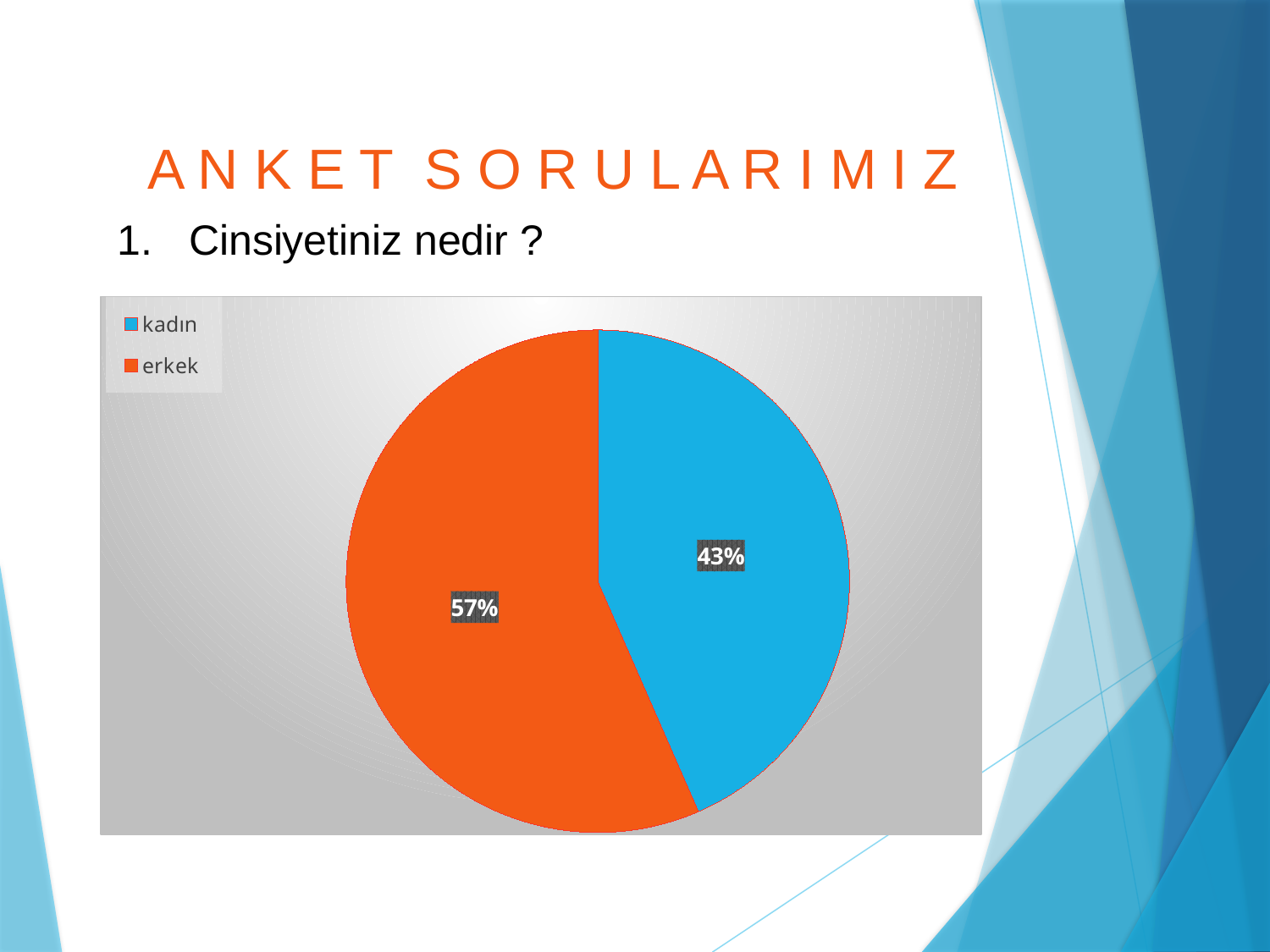
Which category has the largest share of the pie? erkek What colour is the kadın slice? blue What is the difference in percentage points between the erkek and kadın slices? 14% Which category has the smallest share of the pie? kadın How many entries does the legend list? 2 Which is larger, the share for kadın or the share for erkek? erkek What percentage of the pie is labelled for erkek? 57% What share of the pie does the erkek slice represent? 57% What percentage of the pie is labelled for kadın? 43% How many slices does the pie chart have? 2 What kind of chart is shown on the slide? pie chart What colour is the erkek slice? orange